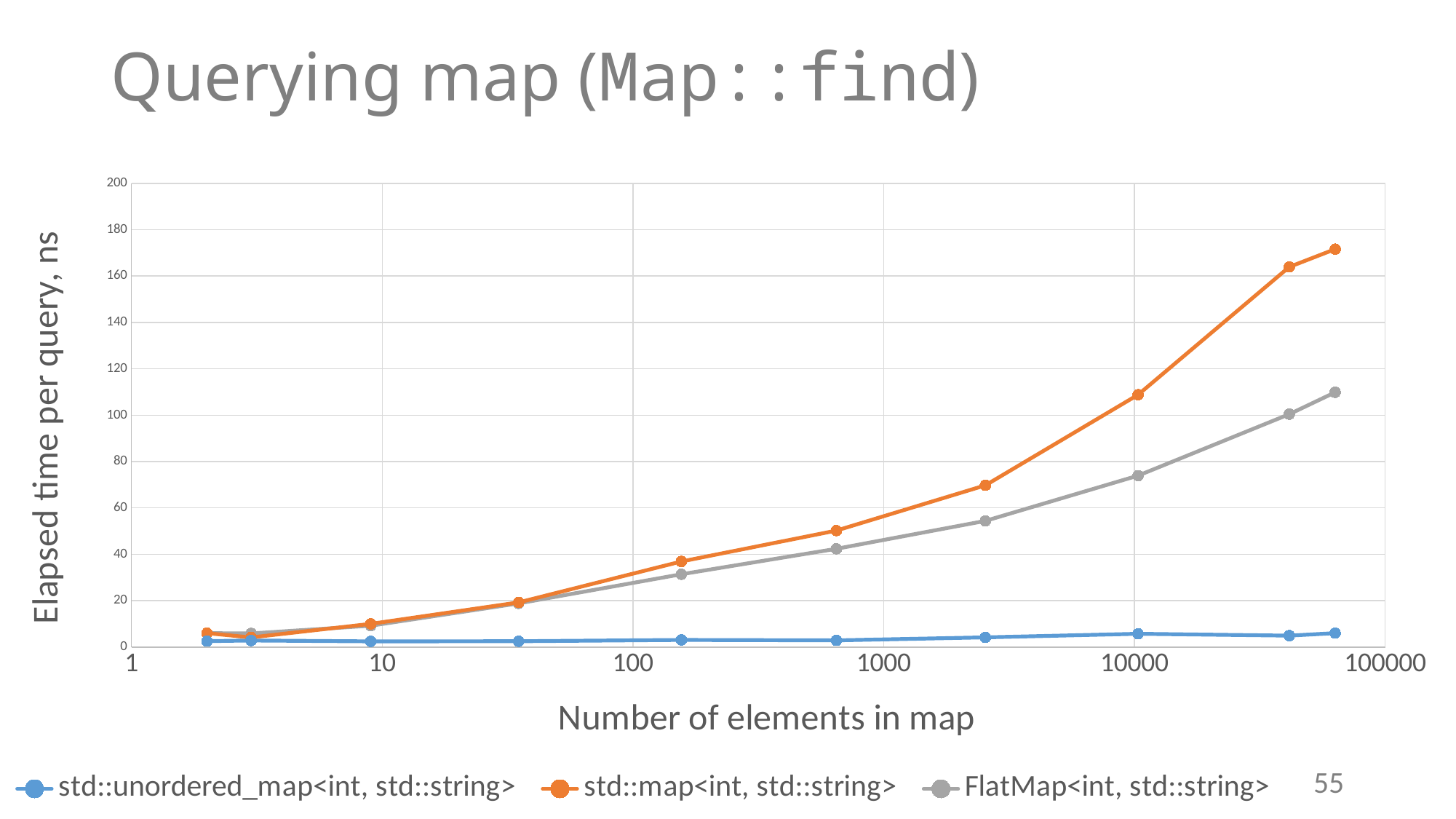
What is the title of the horizontal axis? Number of elements in map How many series does the legend list? 3 At the largest number of elements, which is larger: the value for std::map<int, std::string> or for FlatMap<int, std::string>? std::map<int, std::string> Does the elapsed time for std::map<int, std::string> rise or fall as the number of elements in the map increases? rise What colour is the std::map<int, std::string> line? orange What is the title of the vertical axis? Elapsed time per query, ns Is the value for std::map<int, std::string> at its rightmost point greater or less than 160? greater What kind of chart is shown on the slide? line chart Is the value for FlatMap<int, std::string> at its rightmost point greater or less than 100? greater Which series has the lowest elapsed time per query at the largest number of elements? std::unordered_map<int, std::string> Which series has the highest elapsed time per query at the largest number of elements? std::map<int, std::string> Is the value for std::unordered_map<int, std::string> at its rightmost point greater or less than 20? less